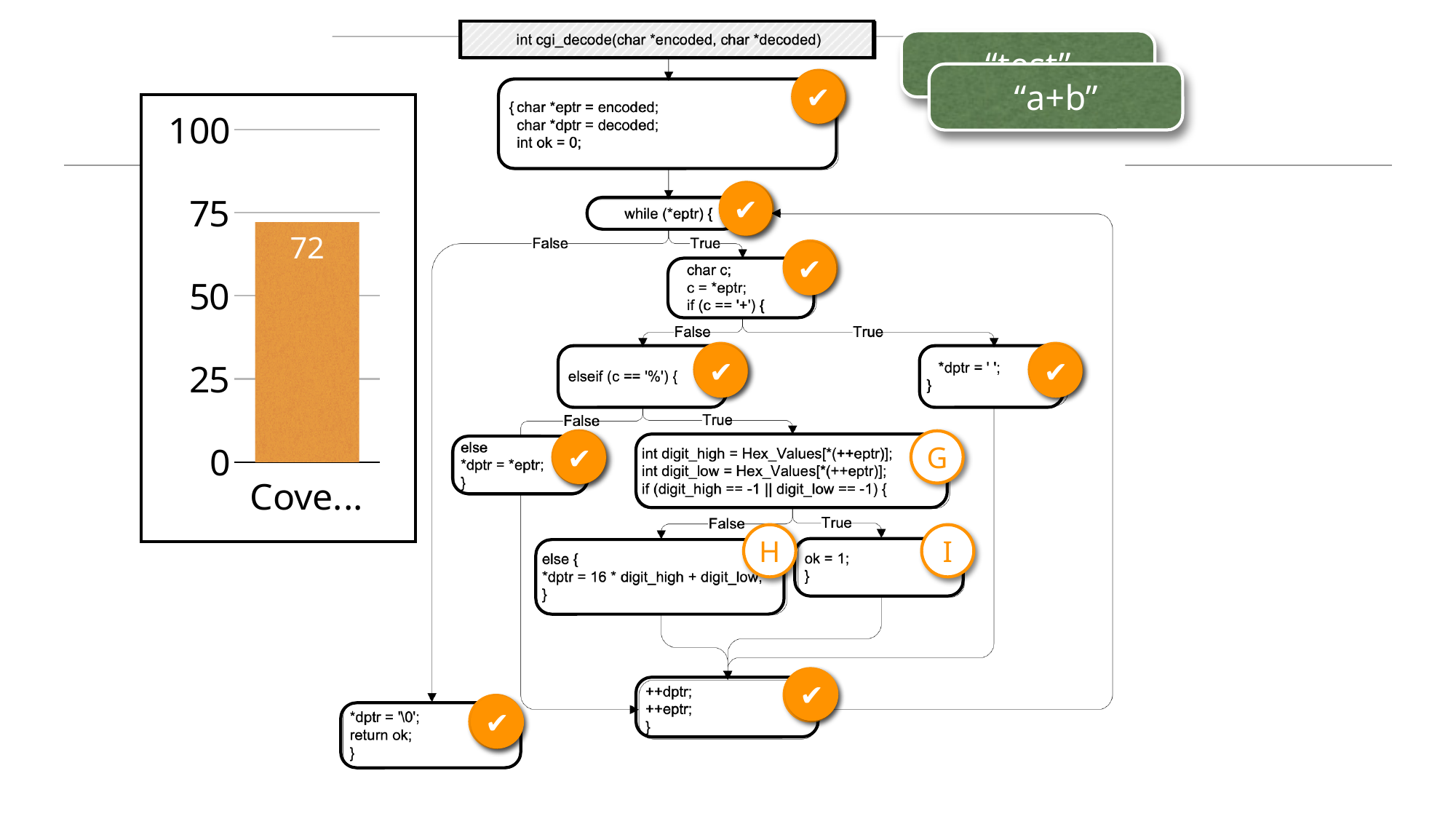
What kind of chart is shown on the left of the slide? bar chart What is the highest tick value shown on the chart's vertical axis? 100 Is the value of the bar greater or less than 75? less Is the value of the bar greater or less than 50? greater What colour is the bar in the chart? orange What value is shown on the bar in the bar chart? 72 How many bars does the chart contain? 1 Is the value of the bar greater or less than 25? greater